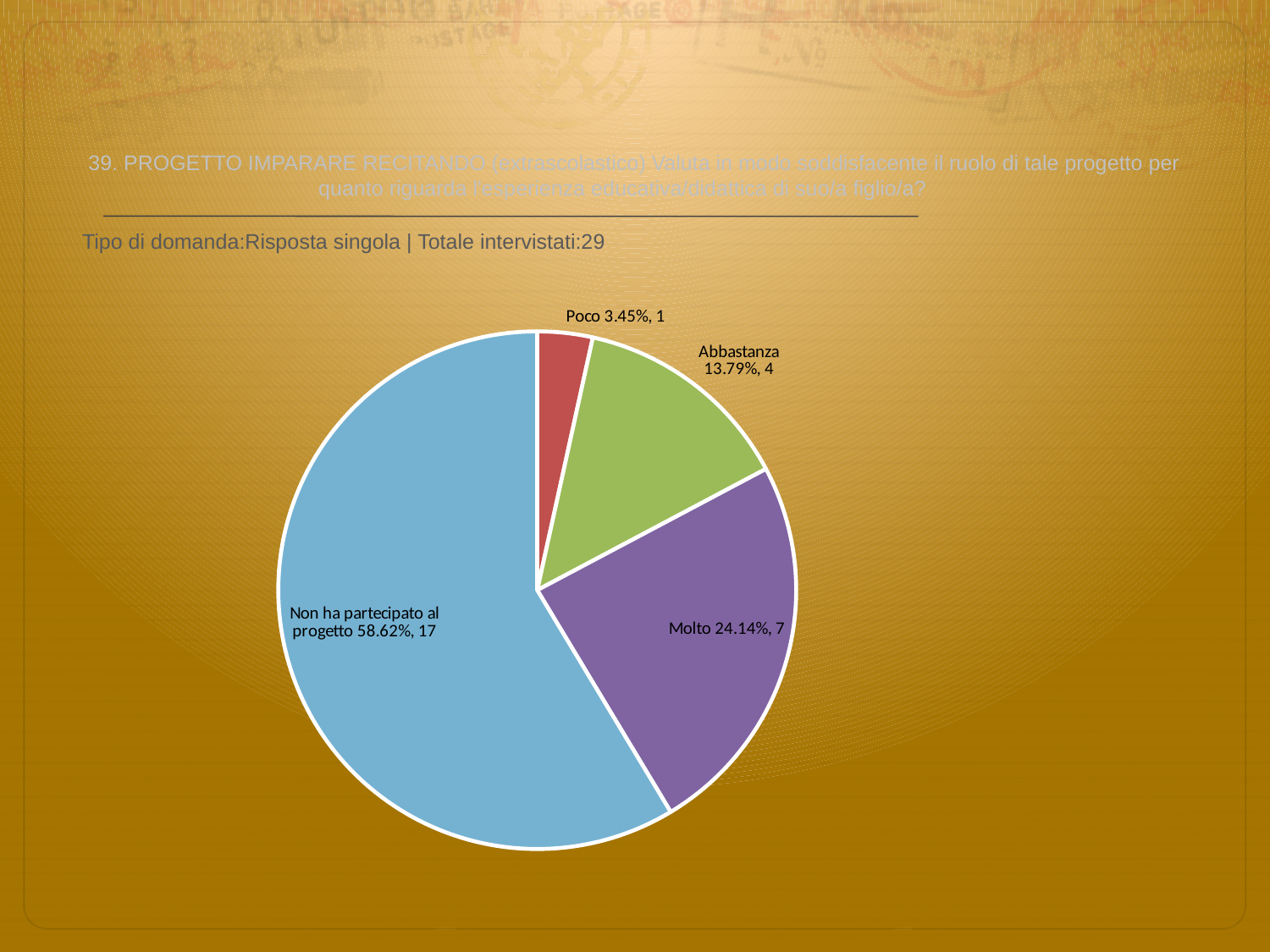
What percentage share does the 'Non ha partecipato al progetto' slice have? 58.62% How many respondents answered 'Poco'? 1 What is the difference in respondent count between 'Molto' and 'Abbastanza'? 3 Which has more respondents, 'Molto' or 'Poco'? Molto What colour is the 'Molto' slice? purple What is the total number of respondents across all slices? 29 What kind of chart is shown on the slide? pie chart How many respondents answered 'Abbastanza'? 4 How many slices does the pie chart have? 4 What percentage share does the 'Molto' slice have? 24.14% Which category has the largest slice? Non ha partecipato al progetto Which category has the smallest slice? Poco